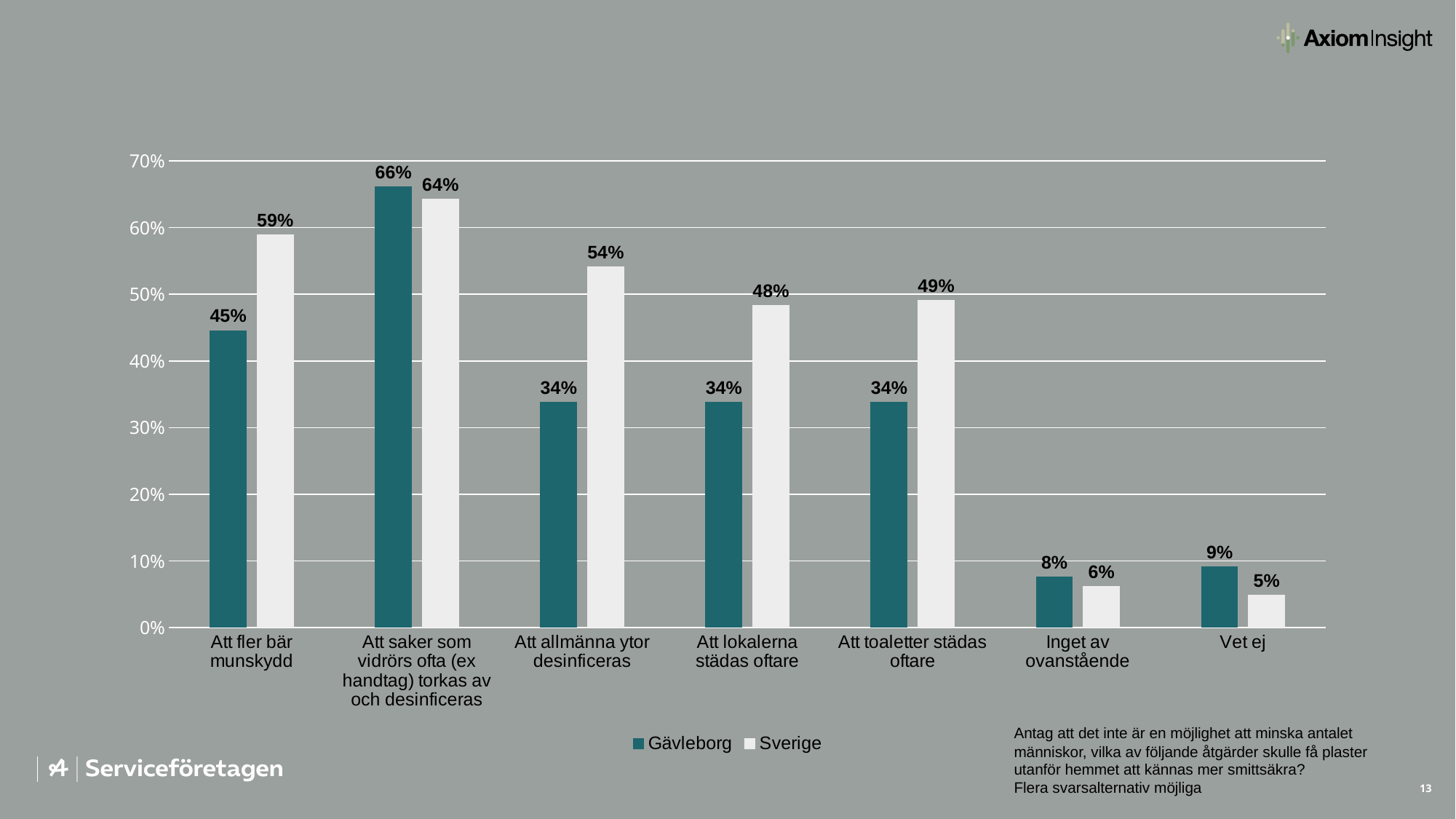
What kind of chart is shown on the slide? Bar chart Is the Gävleborg value for "Att toaletter städas oftare" greater or less than 40%? less For "Att lokalerna städas oftare", which is larger: the Gävleborg value or the Sverige value? Sverige Which series is shown in dark teal in the legend? Gävleborg How many series does the legend list? 2 How many categories are shown on the x axis? 7 What is the difference between the Sverige and Gävleborg values for "Att fler bär munskydd"? 14 percentage points Which category has the lowest Sverige value? Vet ej Which category has the highest Gävleborg value? Att saker som vidrörs ofta (ex handtag) torkas av och desinficeras What is the Sverige value for "Vet ej"? 5% What is the Sverige value for "Att allmänna ytor desinficeras"? 54% What is the Gävleborg value for "Att fler bär munskydd"? 45%